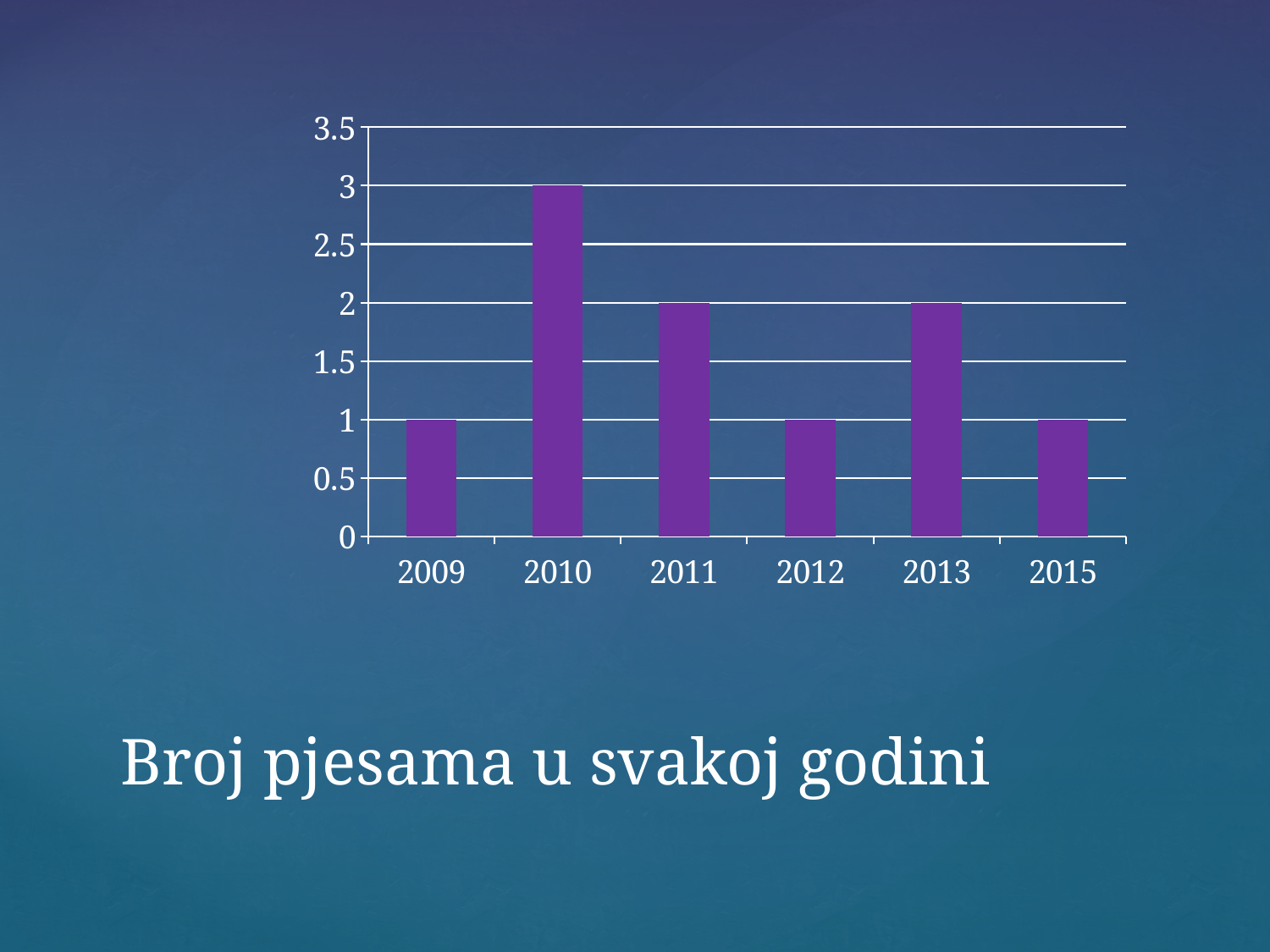
Which is larger, the value for 2013 or the value for 2015? 2013 Which year has the highest value? 2010 How many years are shown on the x axis? 6 What is the value for 2009? 1 What is the value for 2011? 2 What kind of chart is shown on the slide? bar chart Does the value rise or fall from 2010 to 2011? fall What is the text shown below the chart? Broj pjesama u svakoj godini Is the value for 2010 greater or less than 2.5? greater What colour are the bars in the chart? purple What is the value for 2010? 3 What is the difference between the values for 2010 and 2012? 2